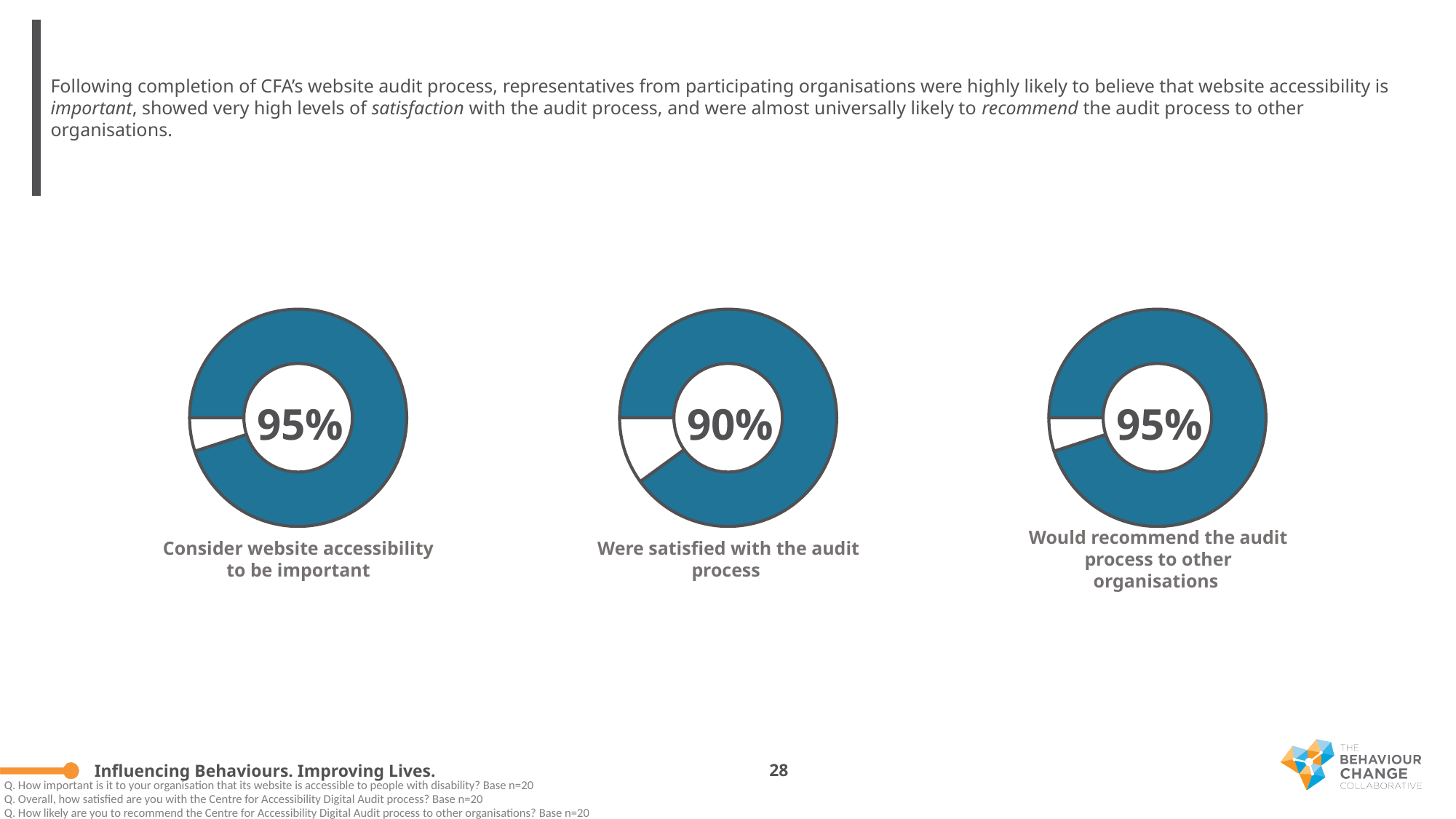
Which of the three measures has the lowest percentage? Were satisfied with the audit process In the middle chart, what share of the donut is not filled by the highlighted 'satisfied' segment? 10% What colour is used for the filled segment in each donut chart? Blue How many donut charts are shown on the slide? 3 In the right chart, what percentage of respondents would recommend the audit process to other organisations? 95% What kind of chart is used to show each of the three percentages on the slide? Donut (pie) chart Which is larger: the percentage who consider website accessibility to be important or the percentage who were satisfied with the audit process? Consider website accessibility to be important In the right chart, what share of the donut is left unfilled (white)? 5% Is the value in the middle chart ('Were satisfied with the audit process') greater or less than 95%? less In the middle chart, what percentage of respondents were satisfied with the audit process? 90% What is the difference in percentage points between the 'Consider website accessibility to be important' chart and the 'Were satisfied with the audit process' chart? 5 percentage points In the left chart, what percentage of respondents consider website accessibility to be important? 95%